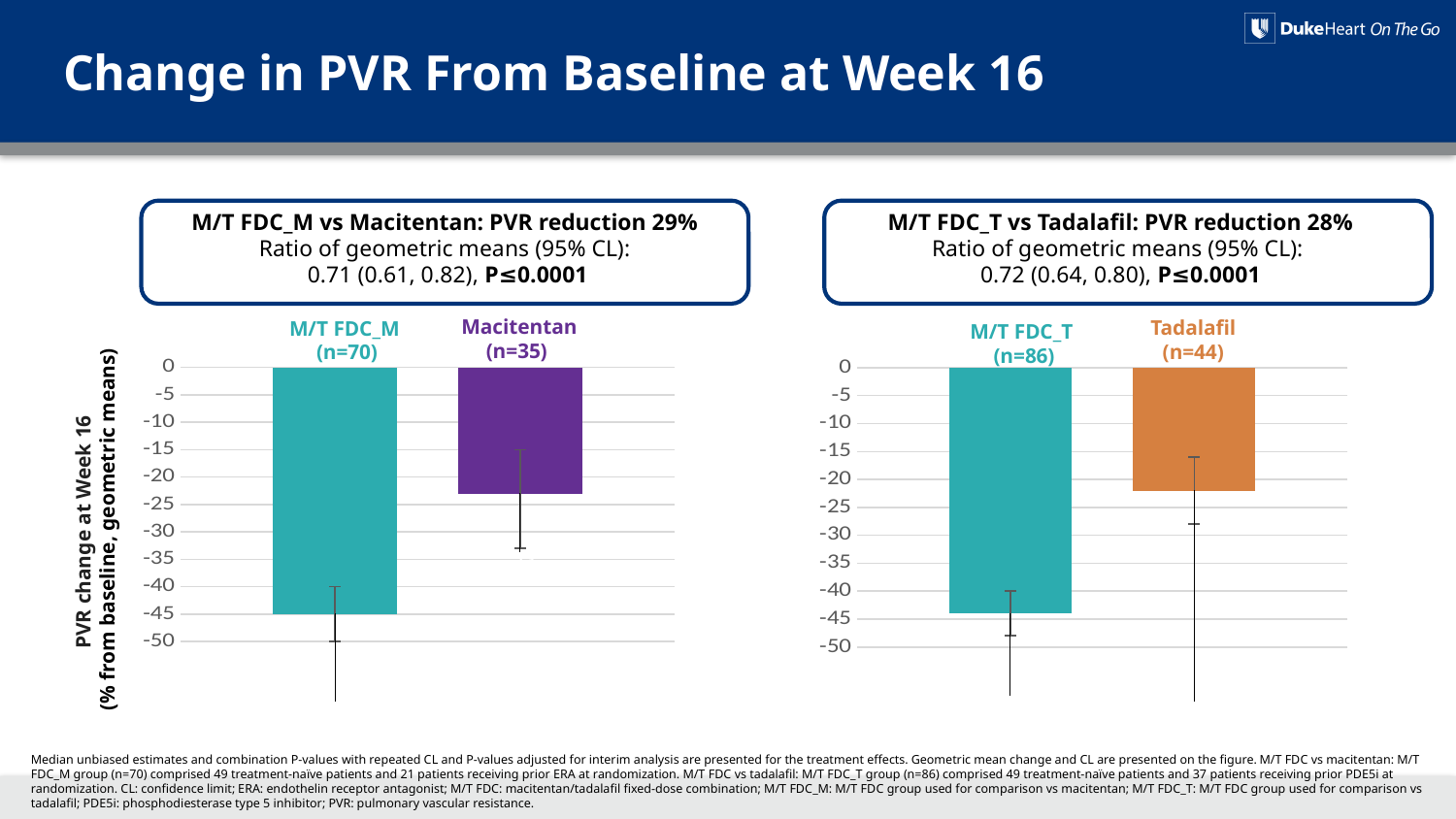
In the right chart (M/T FDC_T vs Tadalafil), is the value for Tadalafil greater or less than -30? greater In the right chart (M/T FDC_T vs Tadalafil), how many bars are plotted? 2 In the left chart (M/T FDC_M vs Macitentan), which group shows the larger PVR reduction from baseline? M/T FDC_M In the left chart (M/T FDC_M vs Macitentan), is the value for M/T FDC_M greater or less than -40? less What kind of chart is the left chart (M/T FDC_M vs Macitentan)? bar chart In the left chart (M/T FDC_M vs Macitentan), how many bars are plotted? 2 In the right chart (M/T FDC_T vs Tadalafil), is the value for M/T FDC_T greater or less than -40? less What is the title of the slide containing the two charts? Change in PVR From Baseline at Week 16 In the left chart (M/T FDC_M vs Macitentan), which group has the lowest (most negative) PVR change? M/T FDC_M In the right chart (M/T FDC_T vs Tadalafil), which group shows the larger PVR reduction from baseline? M/T FDC_T In the right chart (M/T FDC_T vs Tadalafil), what colour is the Tadalafil bar? orange